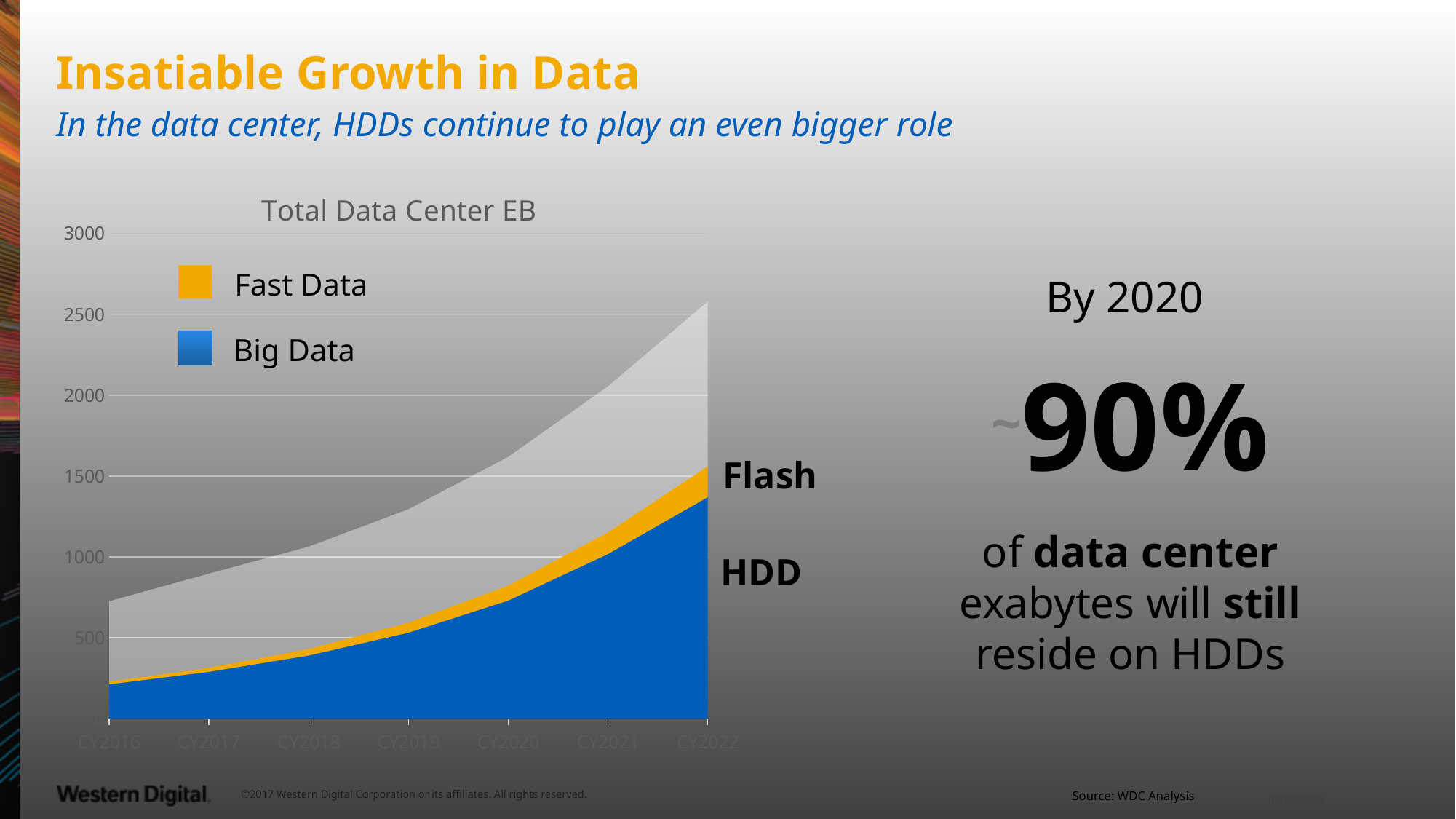
Which colour represents Fast Data in the chart legend? Yellow How many years are shown along the x axis of the chart? 7 What kind of chart is shown on the slide? Area chart Is the total data center EB value for CY2016 greater or less than 1000? less What is the title of the chart? Total Data Center EB How many series does the chart legend list? 2 Is the total data center EB value for CY2022 greater or less than 2000? greater Which year has the highest total data center EB value in the chart? CY2022 Is the Big Data value for CY2020 greater or less than 500? greater Do the values in the chart rise or fall from CY2016 to CY2022? Rise